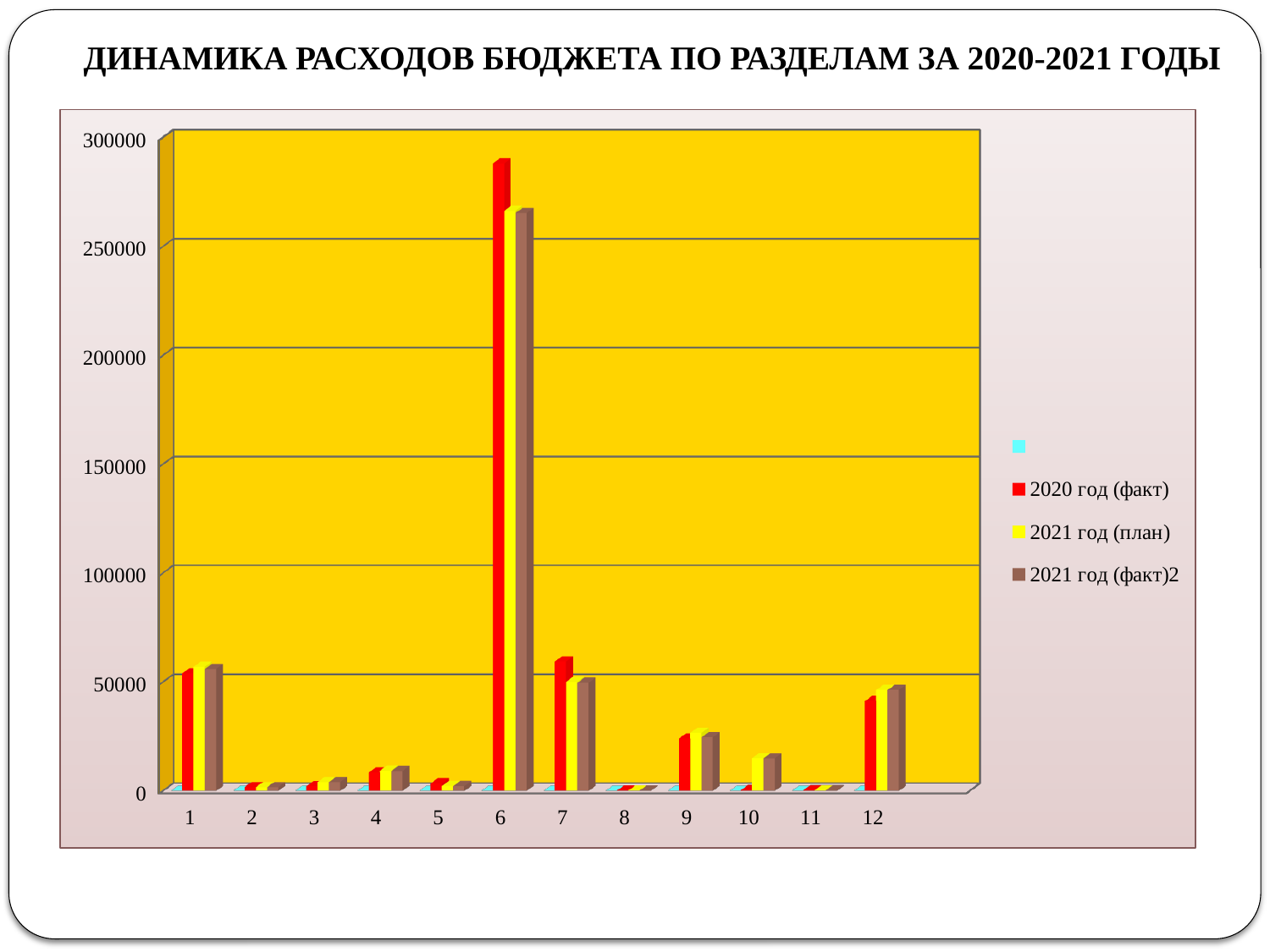
How many labelled series does the legend list? 3 Is the value for category 9 in the 2021 год (план) series greater or less than 50000? less Which is larger for the 2021 год (факт)2 series: category 1 or category 12? category 1 Is the value for category 12 in the 2020 год (факт) series greater or less than 50000? less How many categories are shown along the x axis? 12 What kind of chart is shown on the slide? bar chart Which category has the highest value for the 2020 год (факт) series? 6 Is the value for category 6 in the 2021 год (план) series greater or less than 200000? greater What is the title of the slide? ДИНАМИКА РАСХОДОВ БЮДЖЕТА ПО РАЗДЕЛАМ ЗА 2020-2021 ГОДЫ What colour represents the 2020 год (факт) series in the legend? red Which is larger for the 2020 год (факт) series: category 6 or category 7? category 6